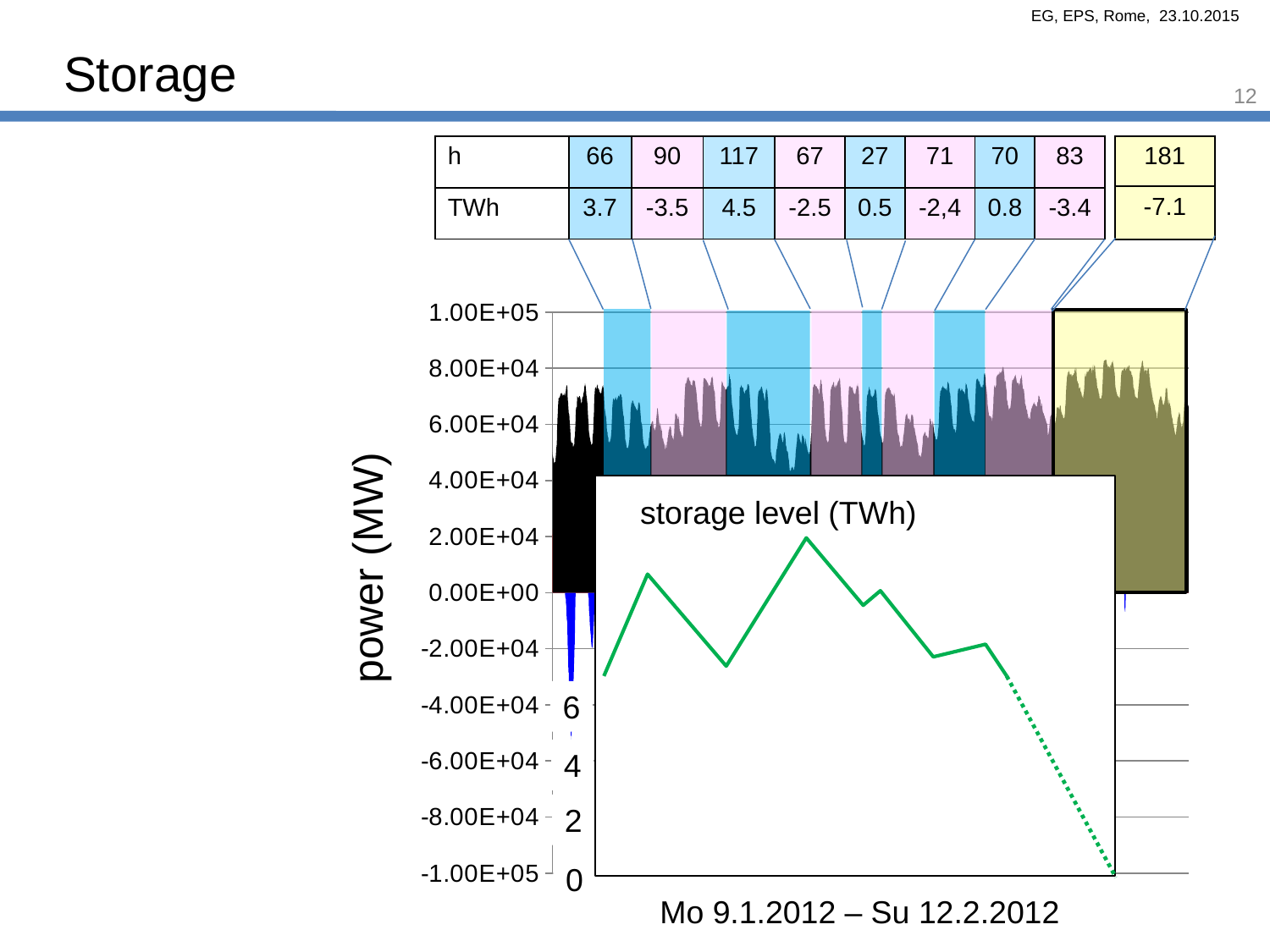
In the table above the chart, what is the largest TWh value? 4.5 In the table above the chart, what is the h value in the yellow column on the right? 181 What is the highest tick value shown on the vertical axis of the main power chart? 1.00E+05 In the inset 'storage level (TWh)' chart, does the dotted line at the right end rise or fall? fall In the table above the chart, which h value is the largest? 181 What is the title of the inset chart in the lower part of the slide? storage level (TWh) What kind of chart is the inset 'storage level (TWh)' chart? line chart What is the lowest tick value shown on the vertical axis of the main power chart? -1.00E+05 In the table above the chart, what is the TWh value in the yellow column on the right? -7.1 What is the label on the vertical axis of the main chart? power (MW) In the table above the chart, what is the lowest TWh value? -7.1 In the table above the chart, what is the difference between the h values of the first two columns (66 and 90)? 24